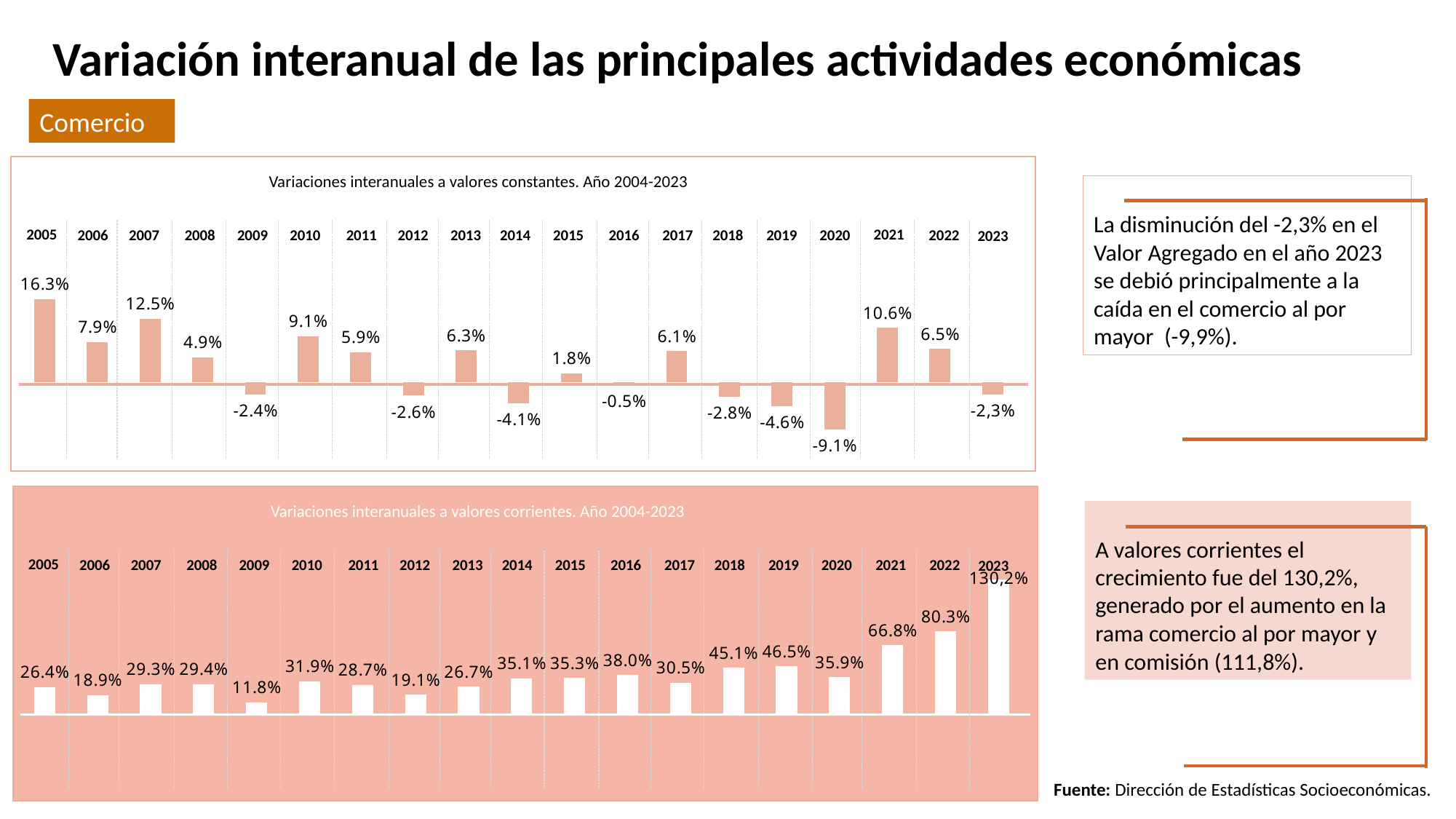
In the top chart (valores constantes), which year has the lowest value? 2020 In the bottom chart (valores corrientes), what is the value for 2022? 80.3% In the bottom chart (valores corrientes), which year has the highest value? 2023 In the top chart (valores constantes), what is the value for 2023? -2,3% In the top chart (valores constantes), how many years are plotted? 19 In the top chart (valores constantes), what is the value for 2005? 16.3% In the bottom chart (valores corrientes), which year has the lowest value? 2009 In the top chart (valores constantes), which is larger, the value for 2007 or the value for 2010? 2007 In the top chart (valores constantes), what is the difference between the values for 2021 and 2022? 4.1 percentage points What kind of chart is the bottom chart (valores corrientes)? Bar chart In the bottom chart (valores corrientes), what is the difference between the values for 2019 and 2018? 1.4 percentage points What is the title of the top chart? Variaciones interanuales a valores constantes. Año 2004-2023